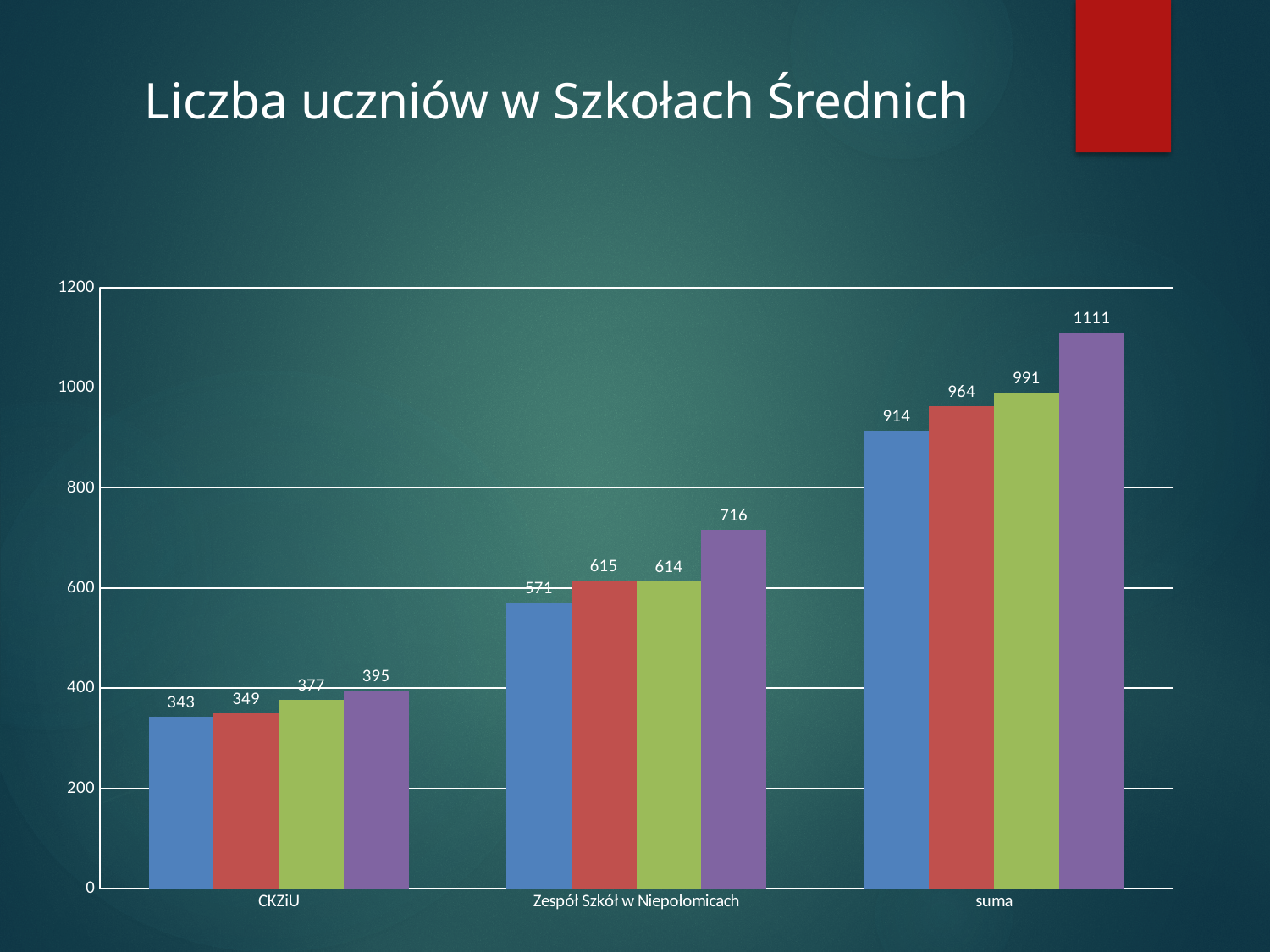
What kind of chart is shown on the slide? bar chart What is the value of the blue bar for CKZiU? 343 Which is larger: the green bar for CKZiU or the blue bar for Zespół Szkół w Niepołomicach? the blue bar for Zespół Szkół w Niepołomicach What is the title of the chart? Liczba uczniów w Szkołach Średnich What is the value of the purple bar for suma? 1111 What is the value of the red bar for Zespół Szkół w Niepołomicach? 615 Is the value of the blue bar for suma greater or less than 800? greater How many categories are shown on the x axis? 3 Which category has the lowest blue bar? CKZiU Which category has the highest purple bar? suma What is the difference between the purple bar and the blue bar for suma? 197 How many bars are plotted for each category? 4